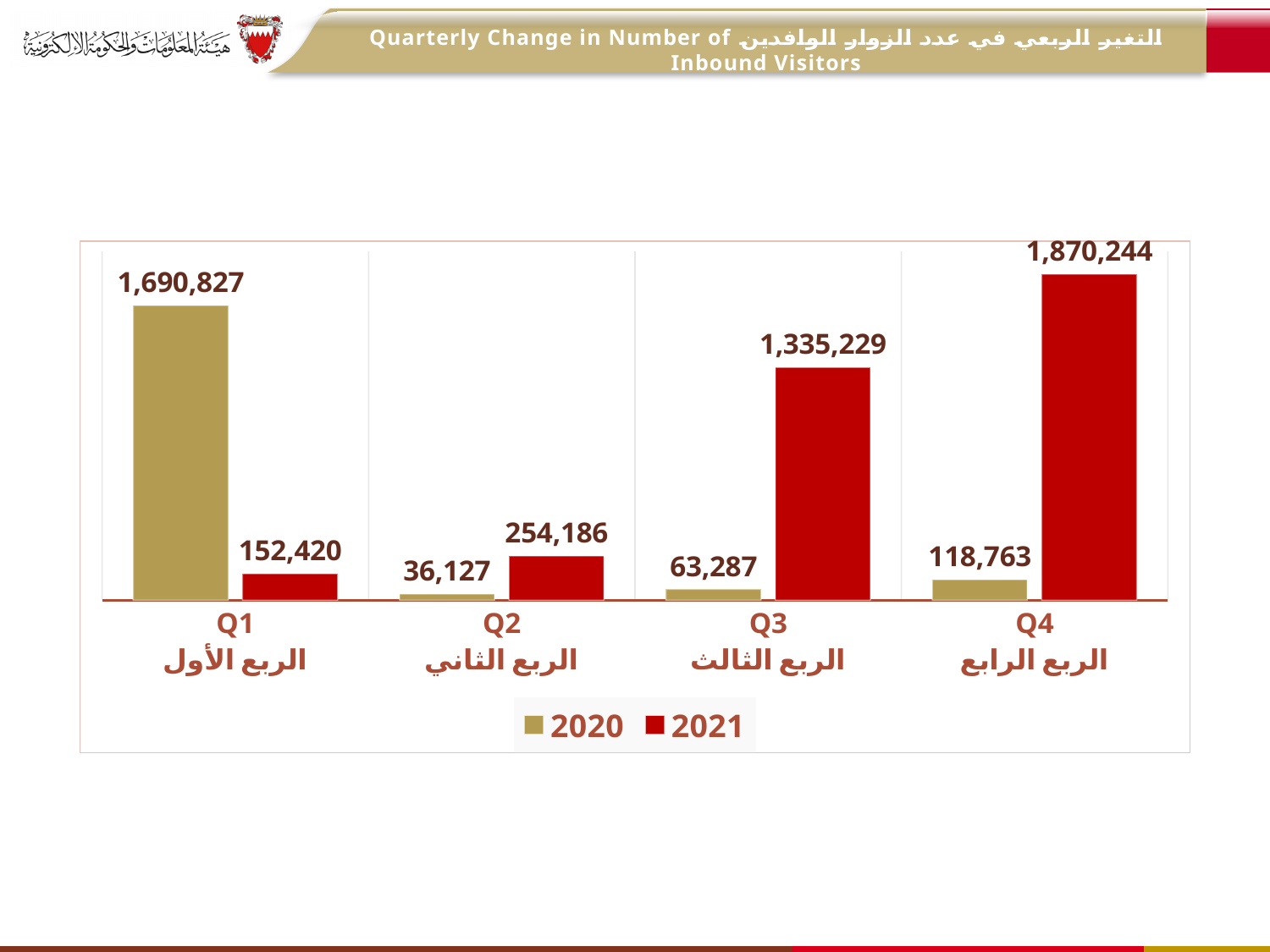
What is the difference between the 2020 and 2021 values in Q1? 1,538,407 Do the 2021 values rise or fall from Q1 to Q4? rise What is the value for 2021 in Q2? 254,186 What is the value for 2020 in Q1? 1,690,827 How many quarters are shown on the x axis? 4 What is the difference between the 2021 and 2020 values in Q4? 1,751,481 In which quarter is the 2020 value lowest? Q2 What is the value for 2020 in Q3? 63,287 What is the value for 2021 in Q4? 1,870,244 In which quarter is the 2021 value highest? Q4 Which is larger in Q3, the 2020 value or the 2021 value? 2021 How many series does the legend list? 2